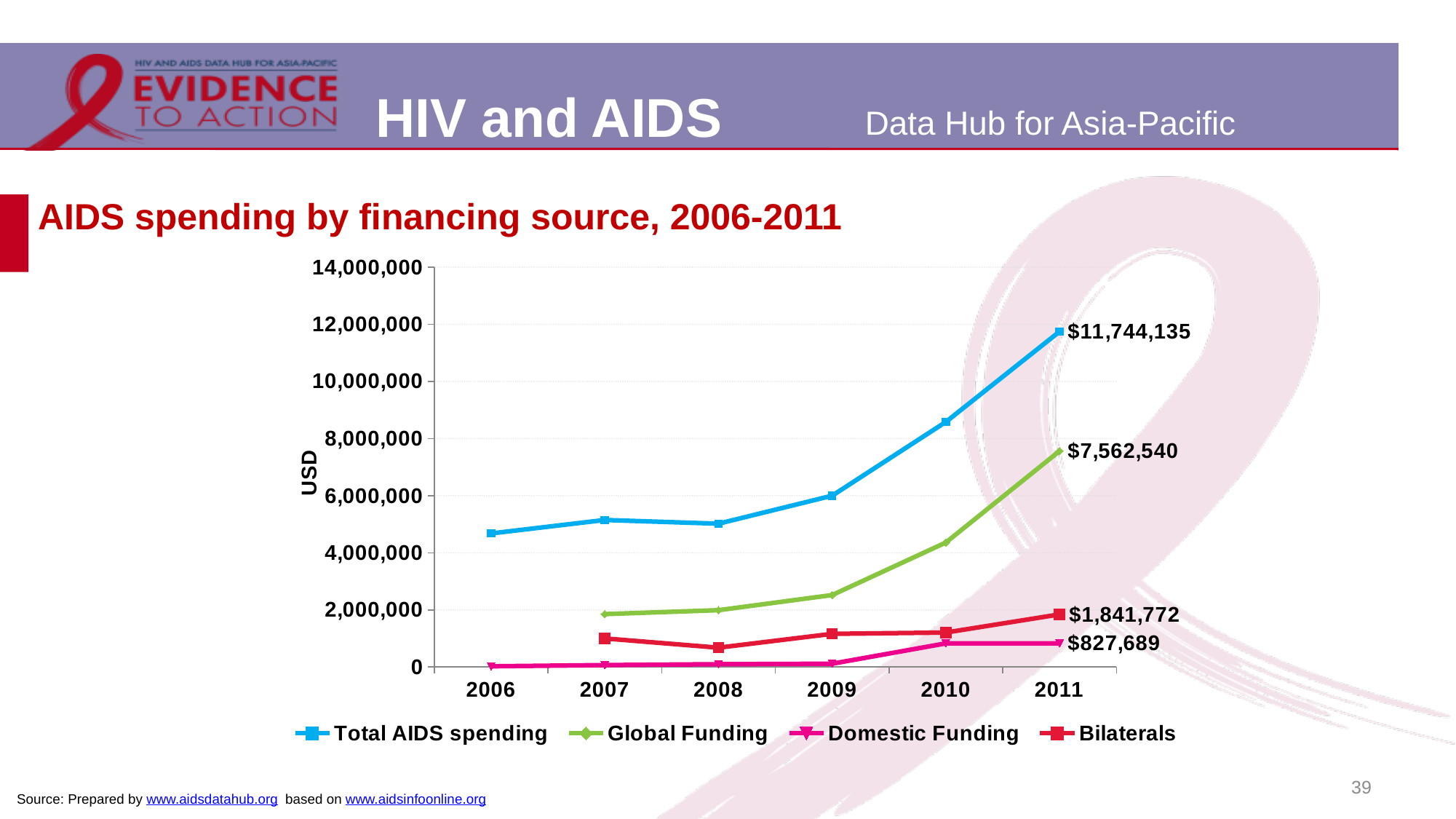
Which is larger in 2011, Global Funding or Bilaterals? Global Funding How many series does the legend list? 4 What is the value for Bilaterals in 2011? $1,841,772 Is the value for Total AIDS spending in 2010 greater or less than 8,000,000? greater Is the value for Total AIDS spending in 2006 greater or less than 6,000,000? less How many years are shown on the x axis? 6 What kind of chart is shown on the slide? Line chart Which series has the lowest value in 2011? Domestic Funding What is the value for Global Funding in 2011? $7,562,540 What is the value for Total AIDS spending in 2011? $11,744,135 What is the value for Domestic Funding in 2011? $827,689 What is the difference between Total AIDS spending and Global Funding in 2011? $4,181,595